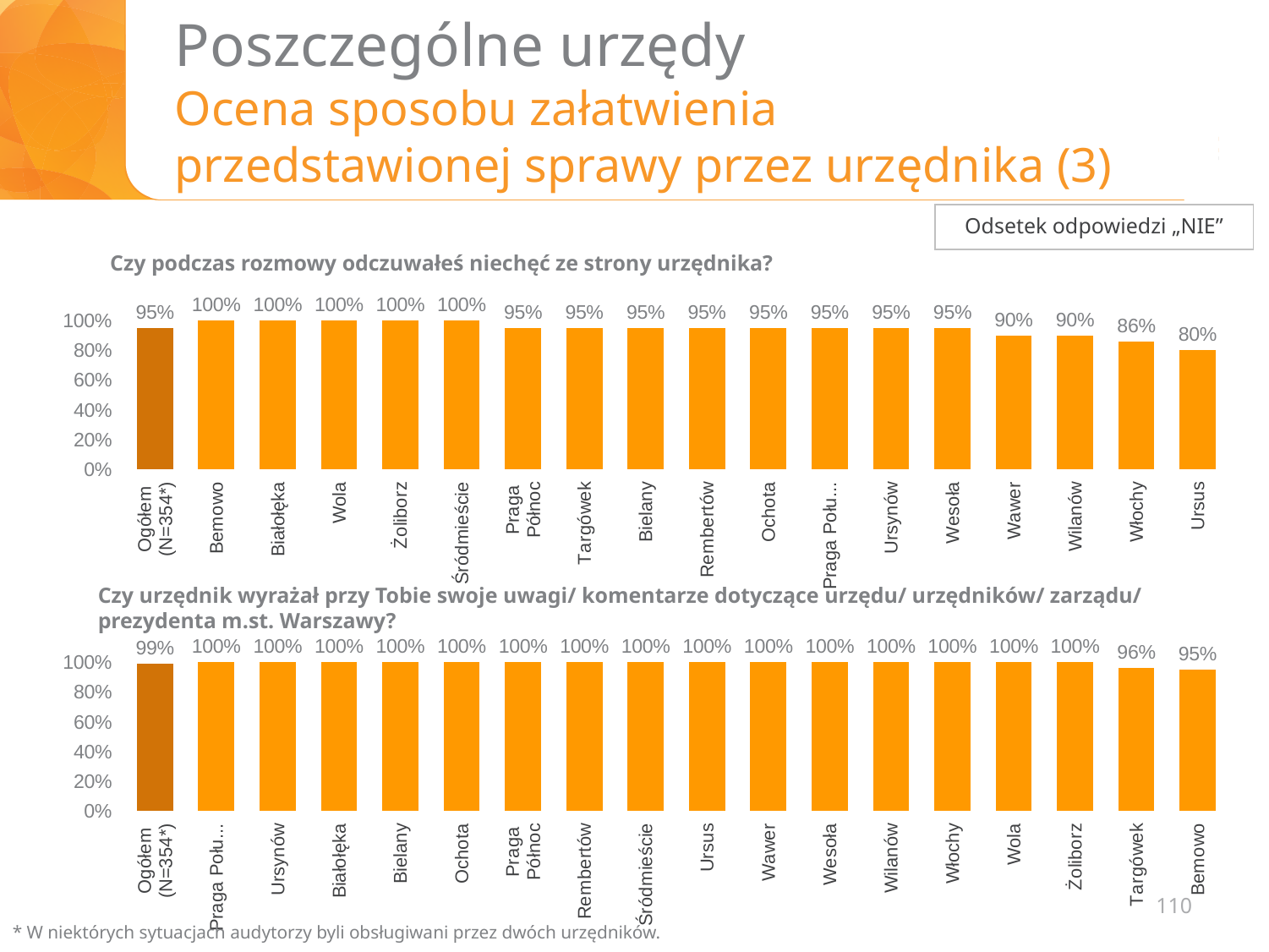
In the top chart (Czy podczas rozmowy odczuwałeś niechęć ze strony urzędnika?), what is the value for Ogółem (N=354*)? 95% In the top chart (Czy podczas rozmowy odczuwałeś niechęć ze strony urzędnika?), what is the difference between the values for Bemowo and Ursus? 20% In the bottom chart (Czy urzędnik wyrażał przy Tobie swoje uwagi...), which category has the lowest value? Bemowo In the top chart (Czy podczas rozmowy odczuwałeś niechęć ze strony urzędnika?), which category has the lowest value? Ursus In the bottom chart (Czy urzędnik wyrażał przy Tobie swoje uwagi...), what is the value for Targówek? 96% In the top chart (Czy podczas rozmowy odczuwałeś niechęć ze strony urzędnika?), which is larger, the value for Wawer or the value for Włochy? Wawer In the top chart (Czy podczas rozmowy odczuwałeś niechęć ze strony urzędnika?), what is the value for Ursus? 80% In the bottom chart (Czy urzędnik wyrażał przy Tobie swoje uwagi...), what is the difference between the values for Ogółem (N=354*) and Bemowo? 4% What kind of chart is the bottom chart (Czy urzędnik wyrażał przy Tobie swoje uwagi...)? Bar chart In the bottom chart (Czy urzędnik wyrażał przy Tobie swoje uwagi...), what is the value for Bemowo? 95% How many categories are shown in the top chart (Czy podczas rozmowy odczuwałeś niechęć ze strony urzędnika?)? 18 In the top chart (Czy podczas rozmowy odczuwałeś niechęć ze strony urzędnika?), what is the value for Włochy? 86%